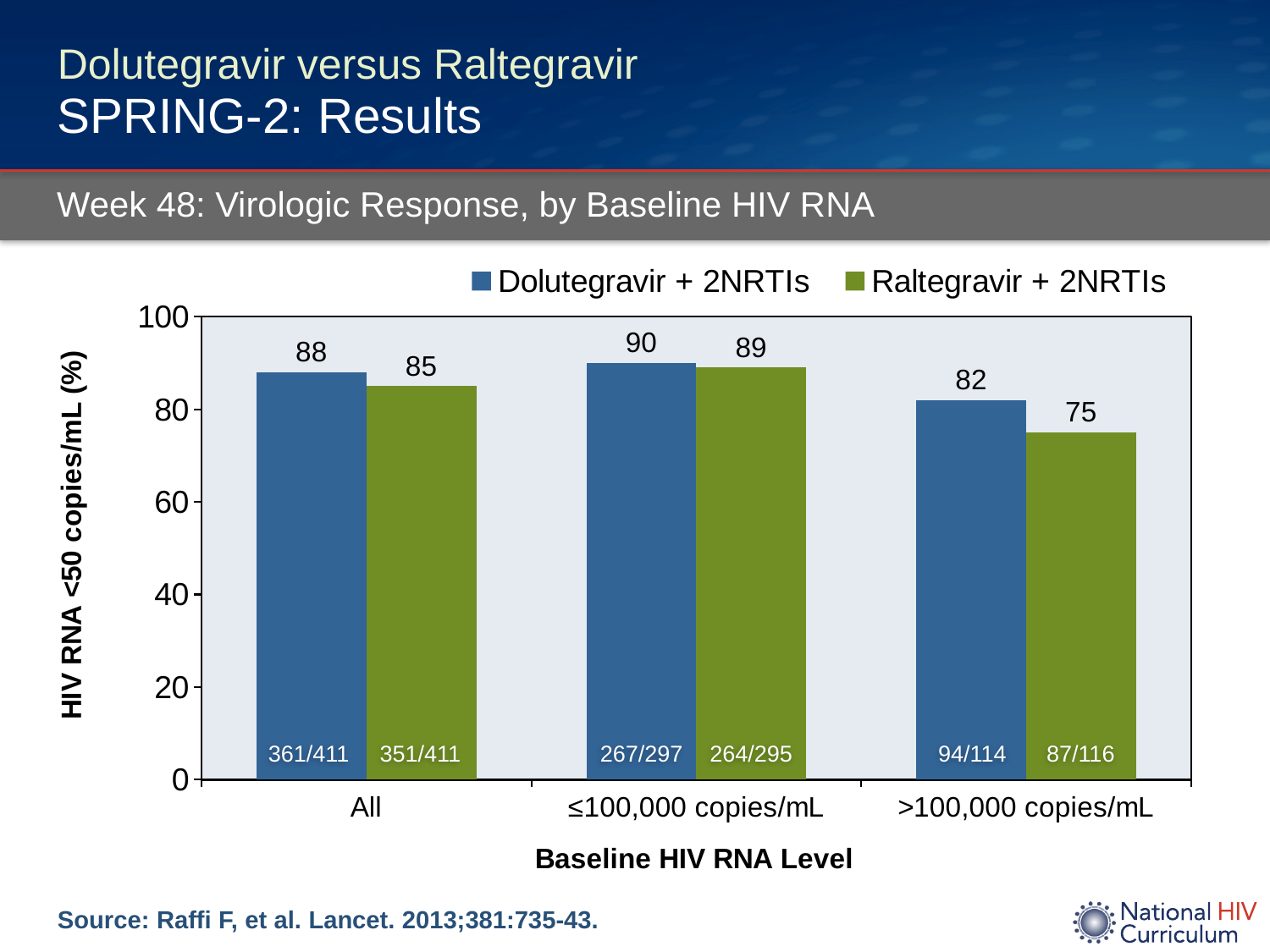
Is the value for Raltegravir + 2NRTIs in the >100,000 copies/mL category greater or less than 80? less What is the value for Raltegravir + 2NRTIs in the ≤100,000 copies/mL category? 89 How many series does the legend list? 2 What kind of chart is shown on the slide? bar chart Which baseline HIV RNA category has the lowest value for Raltegravir + 2NRTIs? >100,000 copies/mL What is the value for Dolutegravir + 2NRTIs in the All category? 88 How many baseline HIV RNA categories are shown on the x axis? 3 What is the value for Raltegravir + 2NRTIs in the >100,000 copies/mL category? 75 What fraction is printed inside the Dolutegravir + 2NRTIs bar for the >100,000 copies/mL category? 94/114 In the All category, which series has the larger value, Dolutegravir + 2NRTIs or Raltegravir + 2NRTIs? Dolutegravir + 2NRTIs Which baseline HIV RNA category has the highest value for Dolutegravir + 2NRTIs? ≤100,000 copies/mL What is the difference between Dolutegravir + 2NRTIs and Raltegravir + 2NRTIs in the >100,000 copies/mL category? 7